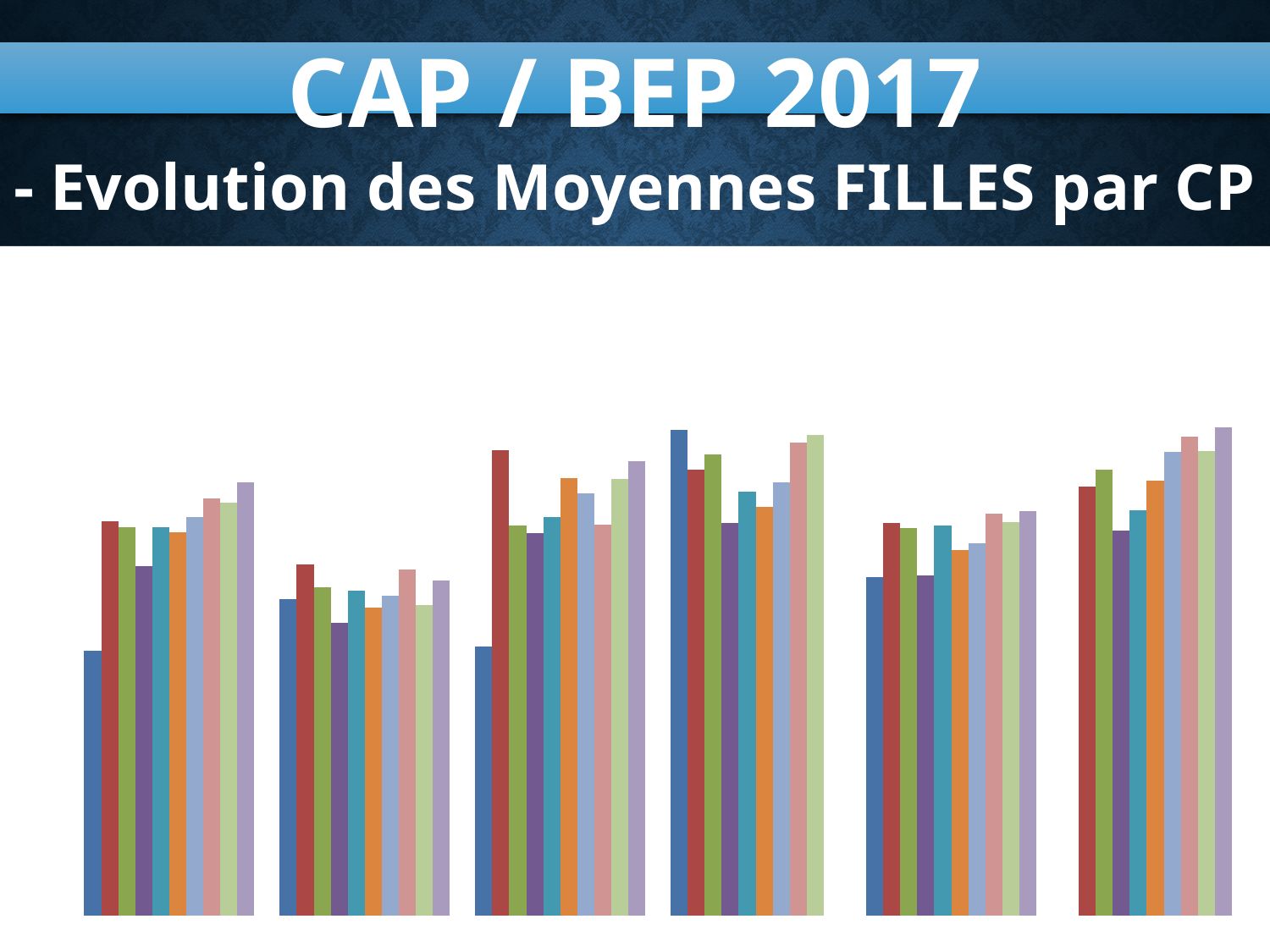
In the leftmost group of bars, which bar is the tallest? the last (light purple) bar Does the chart display a legend? No In the leftmost group of bars, is the first (dark blue) bar taller or shorter than the second (red) bar? shorter How many groups of bars does the chart contain? 6 In the second group of bars from the left, which bar is the shortest? the fourth (purple) bar In the fourth group of bars from the left, which bar is the tallest? the first (dark blue) bar What kind of chart is shown on the slide? bar chart What is the title shown at the top of the slide above the chart? CAP / BEP 2017 - Evolution des Moyennes FILLES par CP